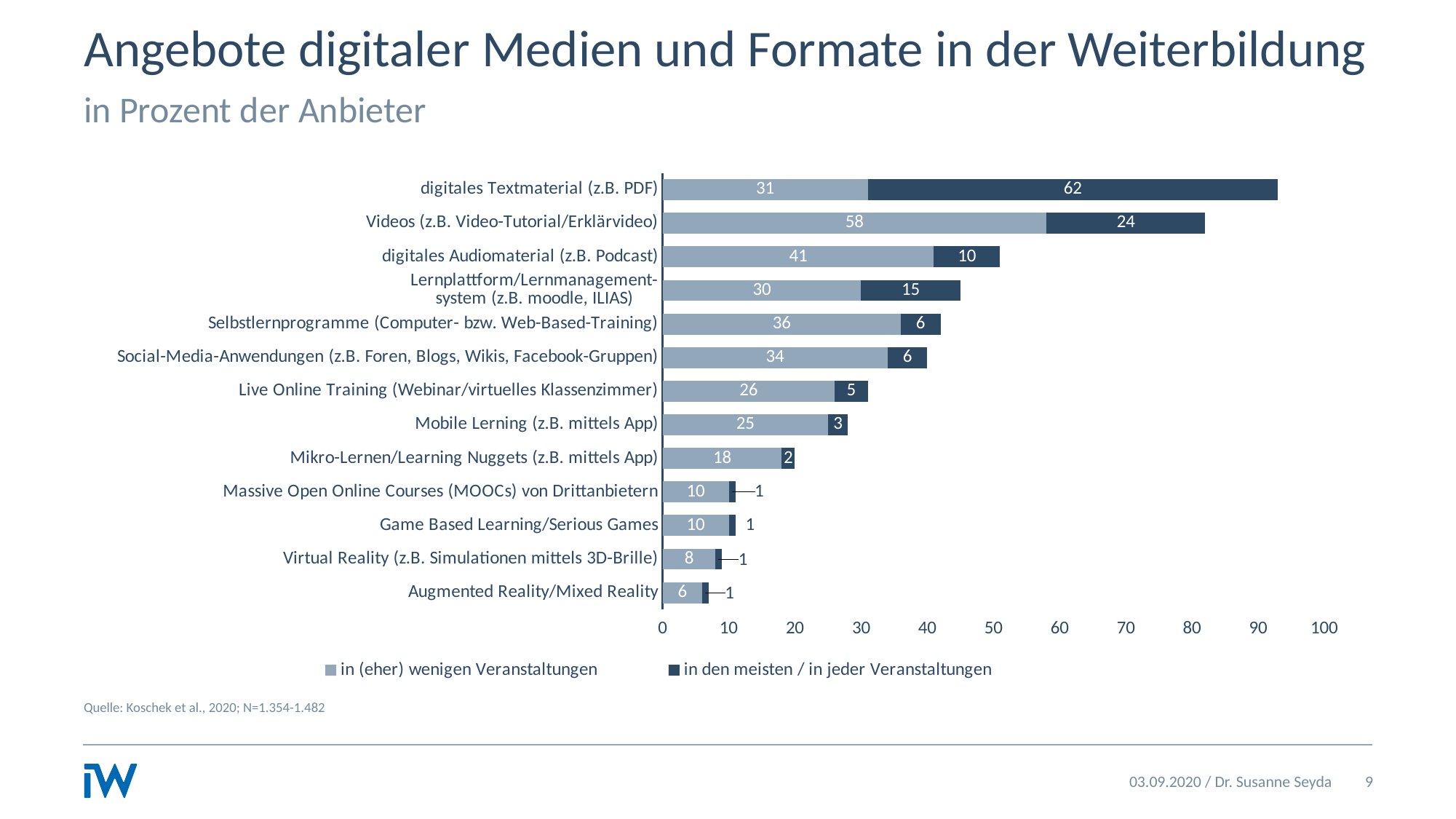
What is the total of the stacked bar for 'digitales Audiomaterial (z.B. Podcast)'? 51 Which is larger: the 'in den meisten / in jeder Veranstaltungen' value for 'Lernplattform/Lernmanagement-system (z.B. moodle, ILIAS)' or for 'digitales Audiomaterial (z.B. Podcast)'? Lernplattform/Lernmanagement-system (z.B. moodle, ILIAS) What is the difference between the 'in (eher) wenigen Veranstaltungen' values for 'Selbstlernprogramme (Computer- bzw. Web-Based-Training)' and 'Mobile Lerning (z.B. mittels App)'? 11 What kind of chart is shown on the slide? stacked bar chart What is the value for 'digitales Textmaterial (z.B. PDF)' in the series 'in den meisten / in jeder Veranstaltungen'? 62 How many series does the legend list? 2 What is the total of the stacked bar for 'Videos (z.B. Video-Tutorial/Erklärvideo)'? 82 Which category has the lowest value in the series 'in (eher) wenigen Veranstaltungen'? Augmented Reality/Mixed Reality How many categories are shown in the chart? 13 What is the value for 'Live Online Training (Webinar/virtuelles Klassenzimmer)' in the series 'in (eher) wenigen Veranstaltungen'? 26 What is the value for 'Videos (z.B. Video-Tutorial/Erklärvideo)' in the series 'in (eher) wenigen Veranstaltungen'? 58 Which category has the highest value in the series 'in den meisten / in jeder Veranstaltungen'? digitales Textmaterial (z.B. PDF)